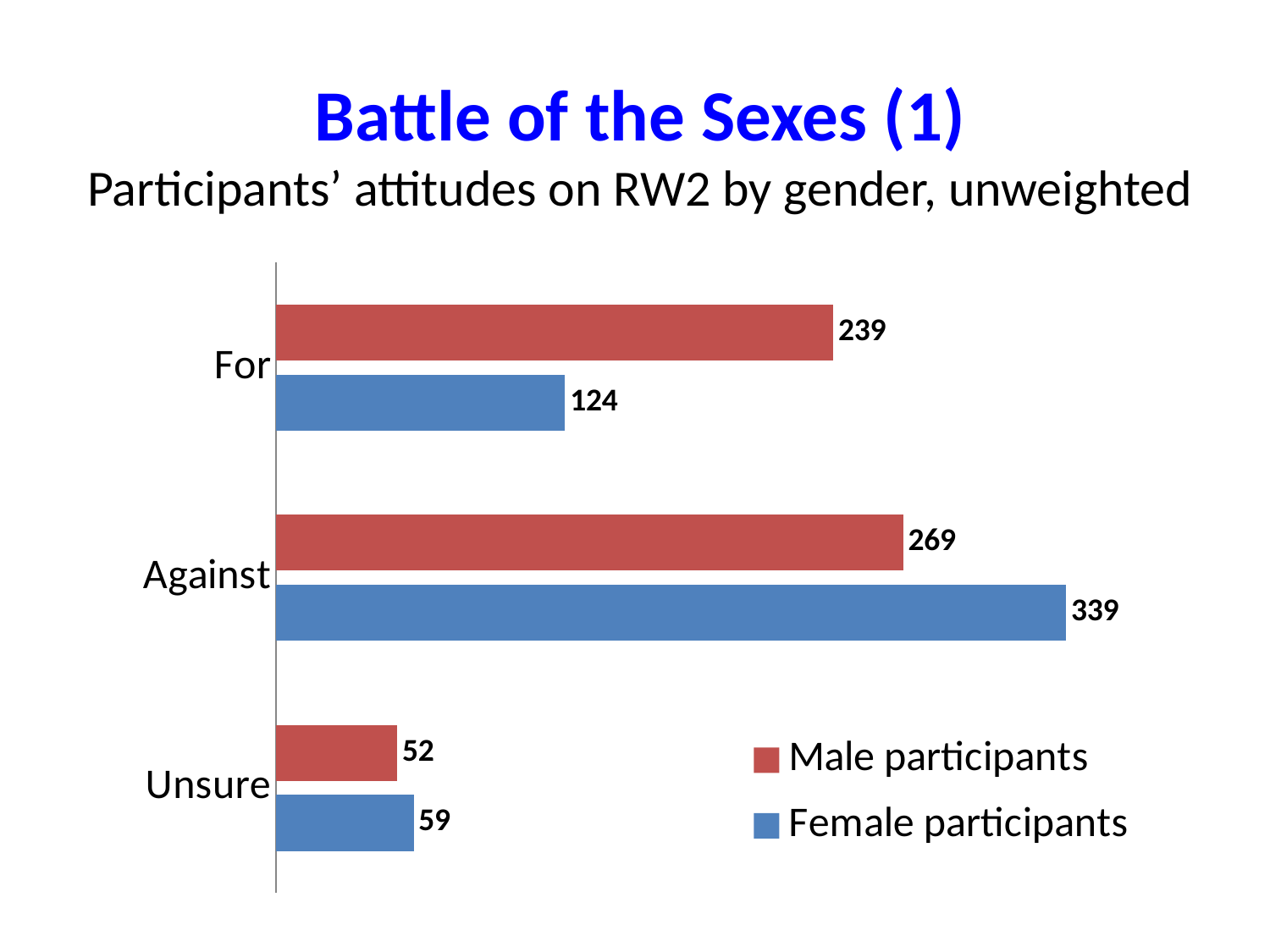
Which category has the lowest value for male participants? Unsure What kind of chart is shown on the slide? Bar chart Which category has the highest value for female participants? Against Which colour represents female participants? Blue Which is larger: male participants For or female participants For? Male participants How many series does the legend list? 2 How many female participants were Against? 339 How many female participants were Unsure? 59 How many male participants were For? 239 What is the difference between female and male participants who were Against? 70 How many categories are shown on the chart? 3 What is the difference between male and female participants who were For? 115